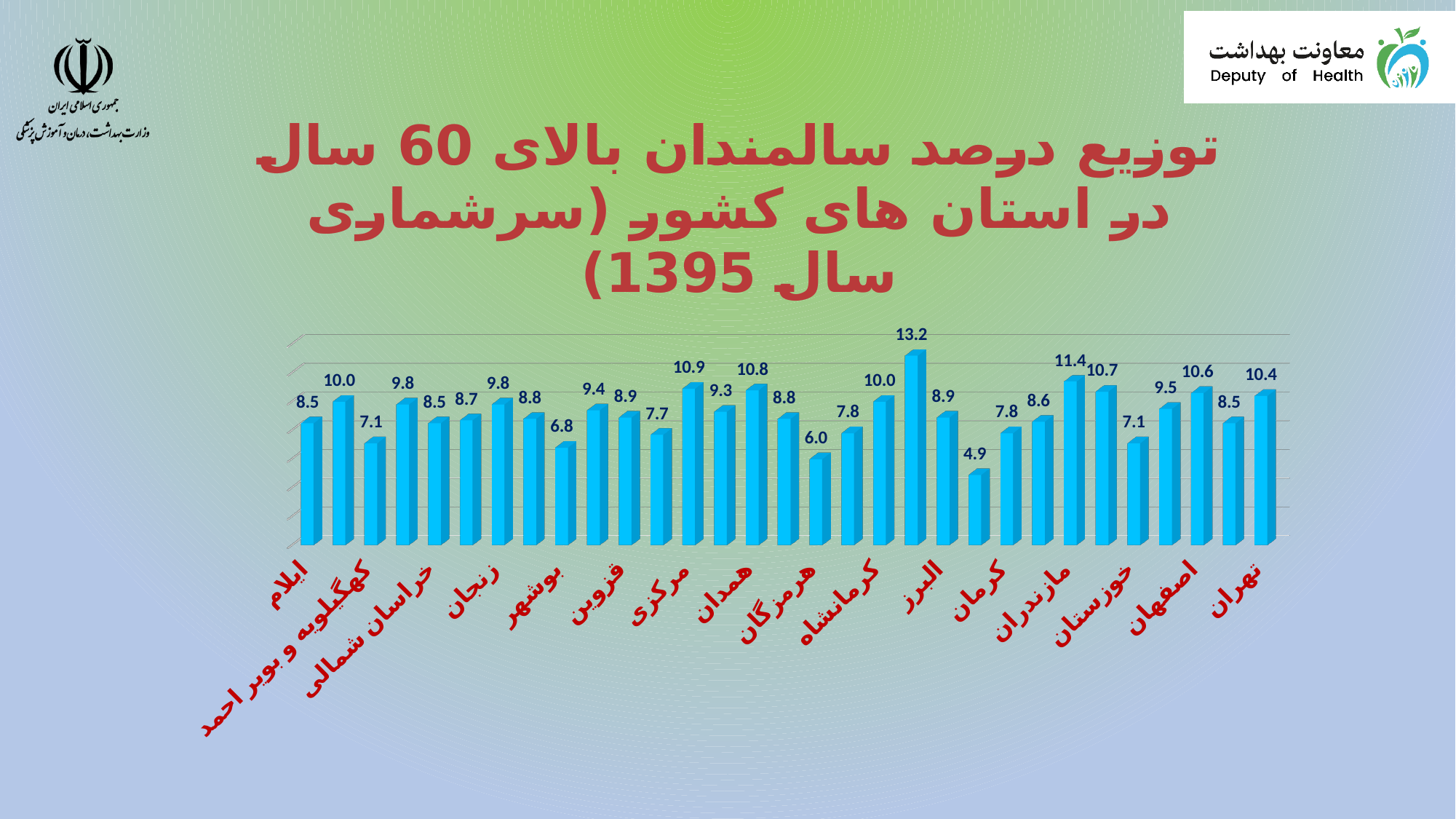
Which has the larger value, مازندران or تهران? مازندران What is the difference between the values for مازندران and هرمزگان? 5.4 What is the lowest value labelled on any bar in the chart? 4.9 What type of chart is shown on the slide? bar chart How many bars are plotted in the chart? 31 What is the value shown for مازندران? 11.4 What is the value shown for اصفهان? 10.6 What is the value shown for هرمزگان? 6.0 What is the value shown for بوشهر? 6.8 What is the highest value labelled on any bar in the chart? 13.2 What year is mentioned in the chart title? 1395 What is the value shown for تهران? 10.4